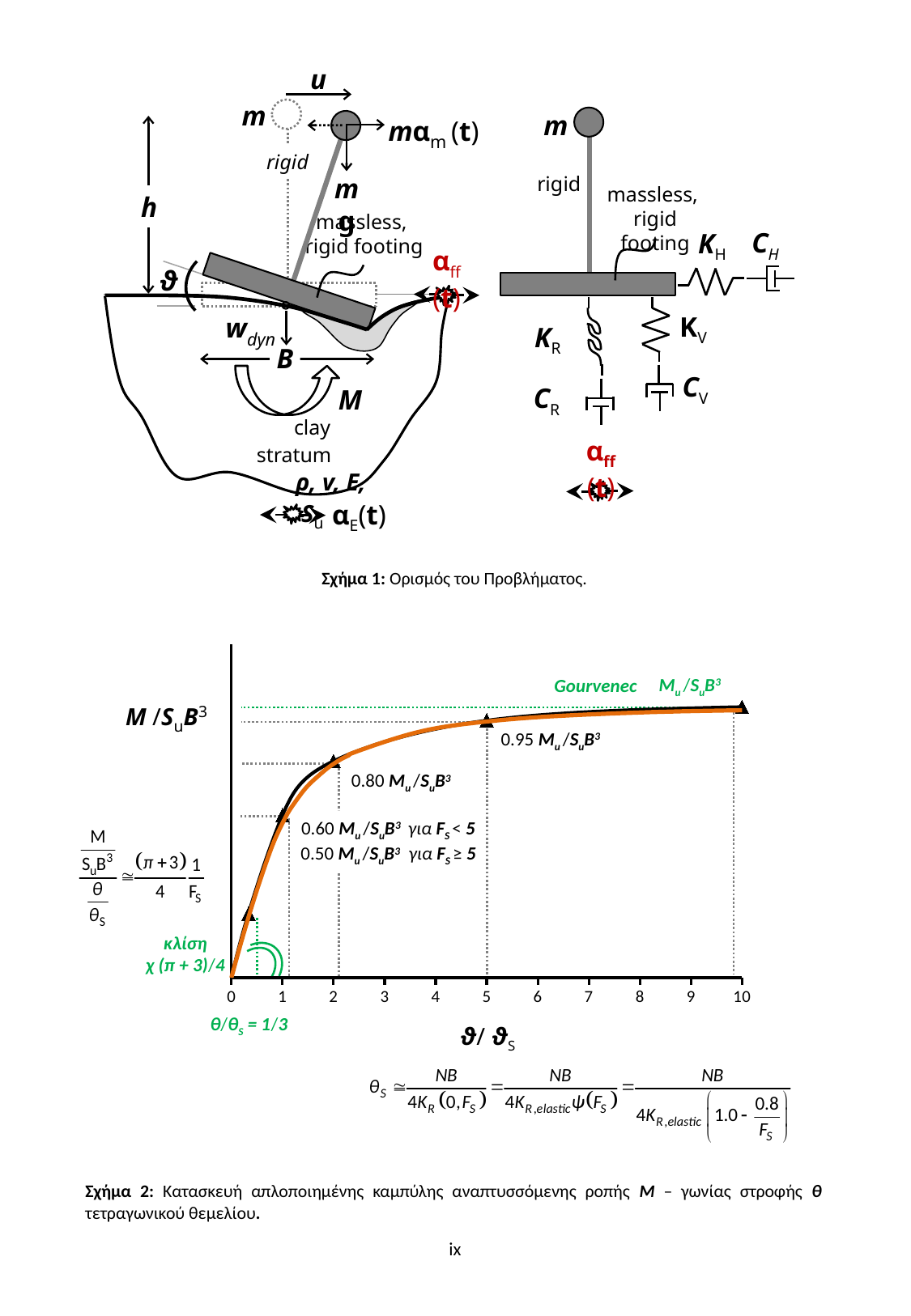
In the chart of Figure 2, what value of M/SuB³ is marked at ϑ/ϑs = 1 for Fs < 5? 0.60 Mu/SuB³ In the chart of Figure 2, what is the difference between the marked values at ϑ/ϑs = 5 and ϑ/ϑs = 2, in units of Mu/SuB³? 0.15 In the chart of Figure 2, what value of M/SuB³ is marked at ϑ/ϑs = 2? 0.80 Mu/SuB³ In the chart of Figure 2, does the curve rise or fall as ϑ/ϑs increases? rise In the chart of Figure 2, what value of M/SuB³ is marked at ϑ/ϑs = 5? 0.95 Mu/SuB³ In the chart of Figure 2, what is the largest value shown on the x axis? 10 In the chart of Figure 2, what is the label on the y axis? M/SuB³ In the chart of Figure 2, what value of M/SuB³ is marked at ϑ/ϑs = 1 for Fs ≥ 5? 0.50 Mu/SuB³ In the chart of Figure 2, what is the label on the x axis? ϑ/ϑs In the chart of Figure 2, how many numbered tick marks are on the x axis? 11 What kind of chart is shown in Figure 2 (Σχήμα 2)? line chart In the chart of Figure 2, which is larger: the marked value at ϑ/ϑs = 5 or at ϑ/ϑs = 2? ϑ/ϑs = 5